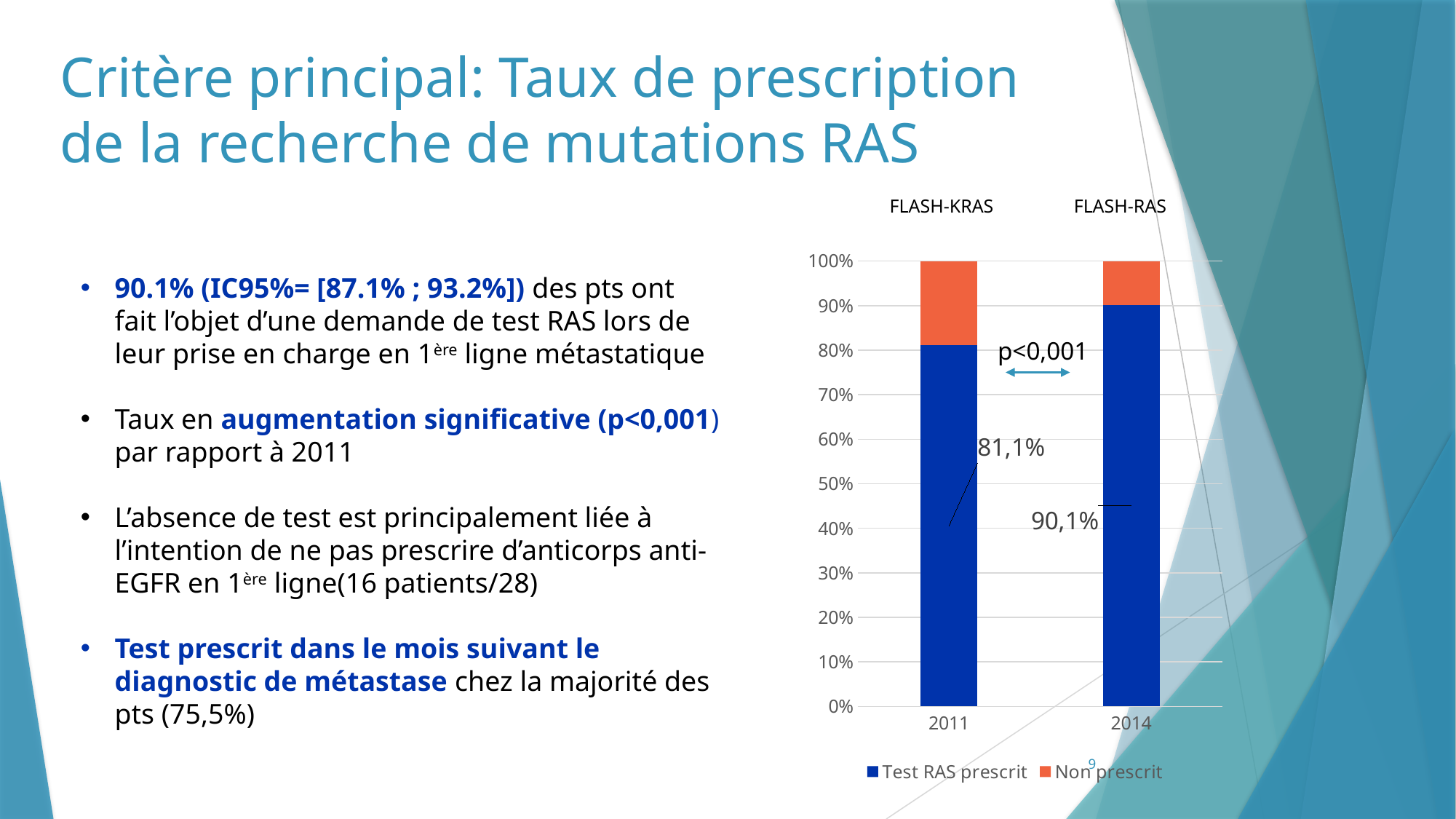
What p-value is annotated between the two bars of the chart? p<0,001 What type of chart is shown on the slide? Stacked bar chart By how many percentage points did the 'Test RAS prescrit' share increase from 2011 to 2014? 9,0% Does the 'Test RAS prescrit' share rise or fall from 2011 to 2014? Rise Is the 'Non prescrit' segment for 2011 greater or less than 10%? greater Which year has the highest 'Test RAS prescrit' share? 2014 What is the value of the 'Test RAS prescrit' segment for 2014? 90,1% How many series does the chart legend list? 2 Which year has the larger 'Test RAS prescrit' share, 2011 or 2014? 2014 What is the value of the 'Test RAS prescrit' segment for 2011? 81,1% Is the 'Non prescrit' segment for 2014 greater or less than 20%? less How many years (categories) are shown on the x axis of the chart? 2